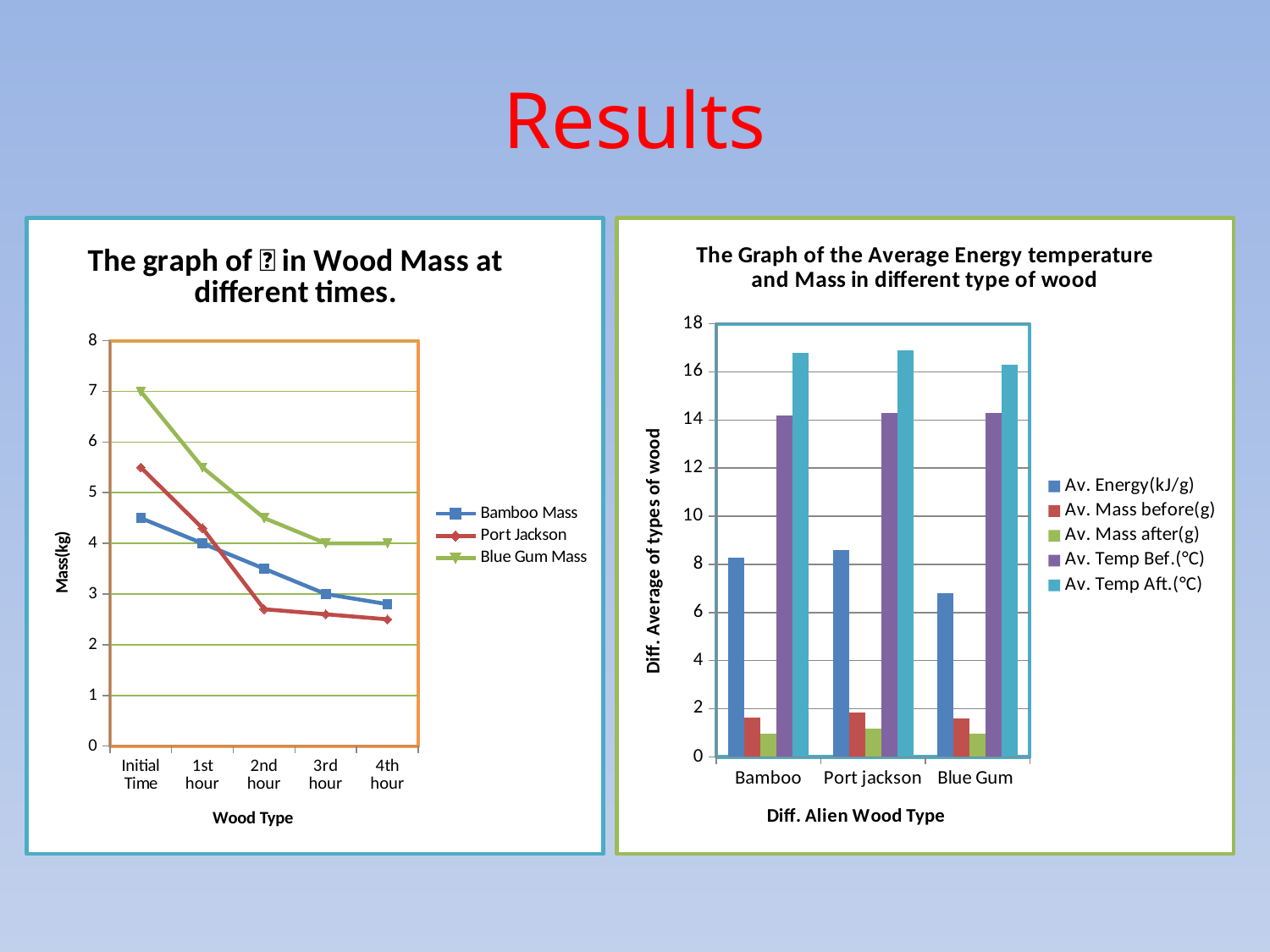
In the left chart (Wood Mass at different times), how many series does the legend list? 3 What type of chart is the left chart, 'The graph of ? in Wood Mass at different times'? line chart In the right chart (Average Energy temperature and Mass), how many wood types are shown on the x axis? 3 In the left chart (Wood Mass at different times), what is the Blue Gum Mass at Initial Time? 7 In the right chart (Average Energy temperature and Mass), which series has the tallest bar for Bamboo? Av. Temp Aft.(°C) In the right chart (Average Energy temperature and Mass), how many series does the legend list? 5 In the right chart (Average Energy temperature and Mass), which is larger, the Av. Energy(kJ/g) for Bamboo or for Blue Gum? Bamboo What type of chart is the right chart, 'The Graph of the Average Energy temperature and Mass in different type of wood'? bar chart In the left chart (Wood Mass at different times), how many time points are shown on the x axis? 5 In the left chart (Wood Mass at different times), does the Bamboo Mass rise or fall from Initial Time to 4th hour? fall In the right chart (Average Energy temperature and Mass), is the Av. Energy(kJ/g) value for Blue Gum greater or less than 8? less In the left chart (Wood Mass at different times), which series has the highest mass at Initial Time? Blue Gum Mass